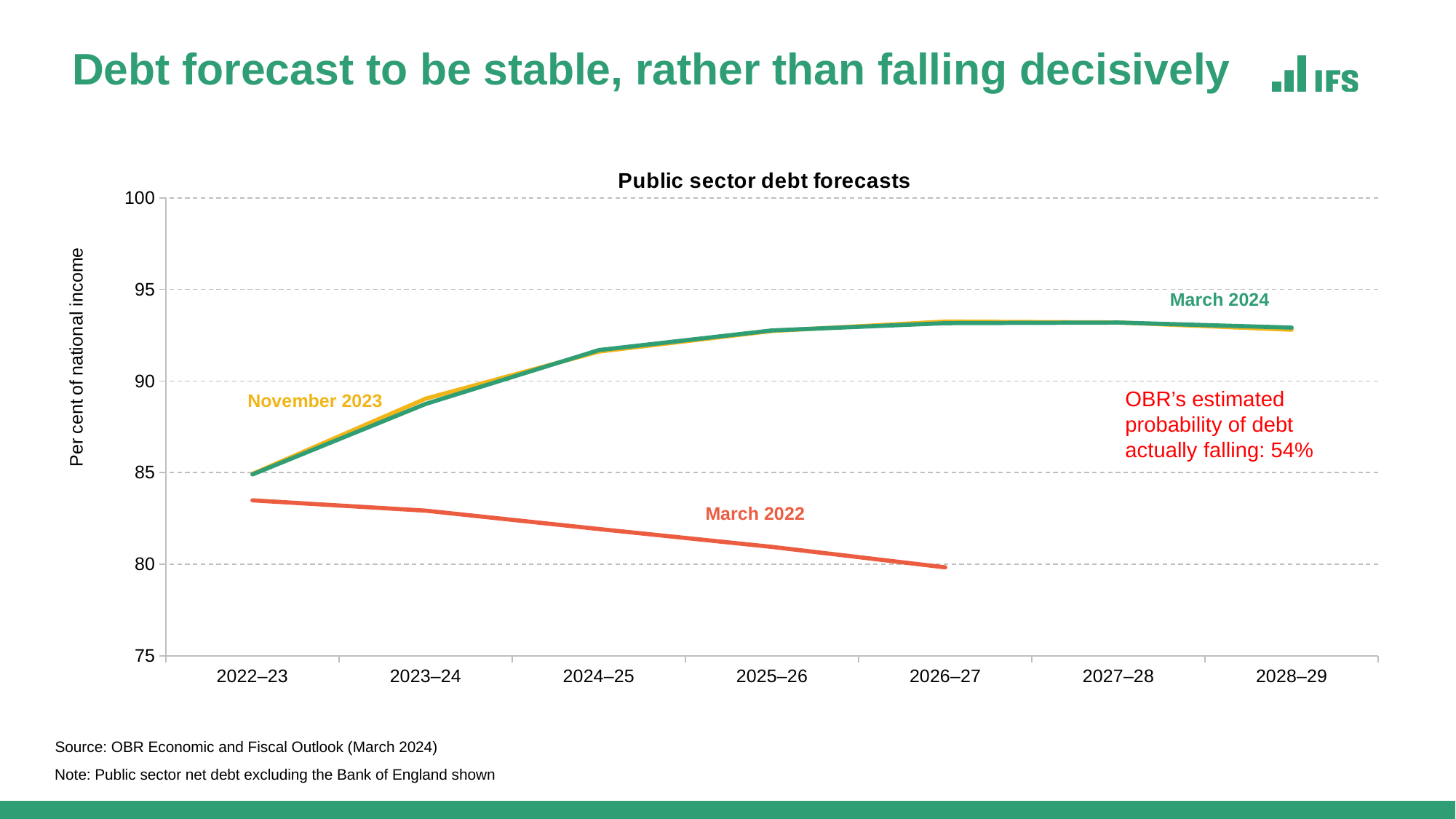
In 2024–25, which forecast is higher: March 2022 or March 2024? March 2024 Which forecast series has the lowest values across the years it covers? March 2022 Is the March 2022 forecast value for 2026–27 greater or less than 85? less What is the title of the chart? Public sector debt forecasts What is the label on the vertical axis of the chart? Per cent of national income How many fiscal years are shown on the x axis? 7 Does the March 2024 forecast line rise or fall between 2022–23 and 2024–25? Rise Is the March 2024 forecast value for 2028–29 greater or less than 90? greater What kind of chart is shown on the slide? Line chart Is the March 2024 forecast value for 2022–23 greater or less than 80? greater Does the March 2022 forecast line rise or fall from 2022–23 to 2026–27? Fall How many forecast series are plotted on the chart? 3